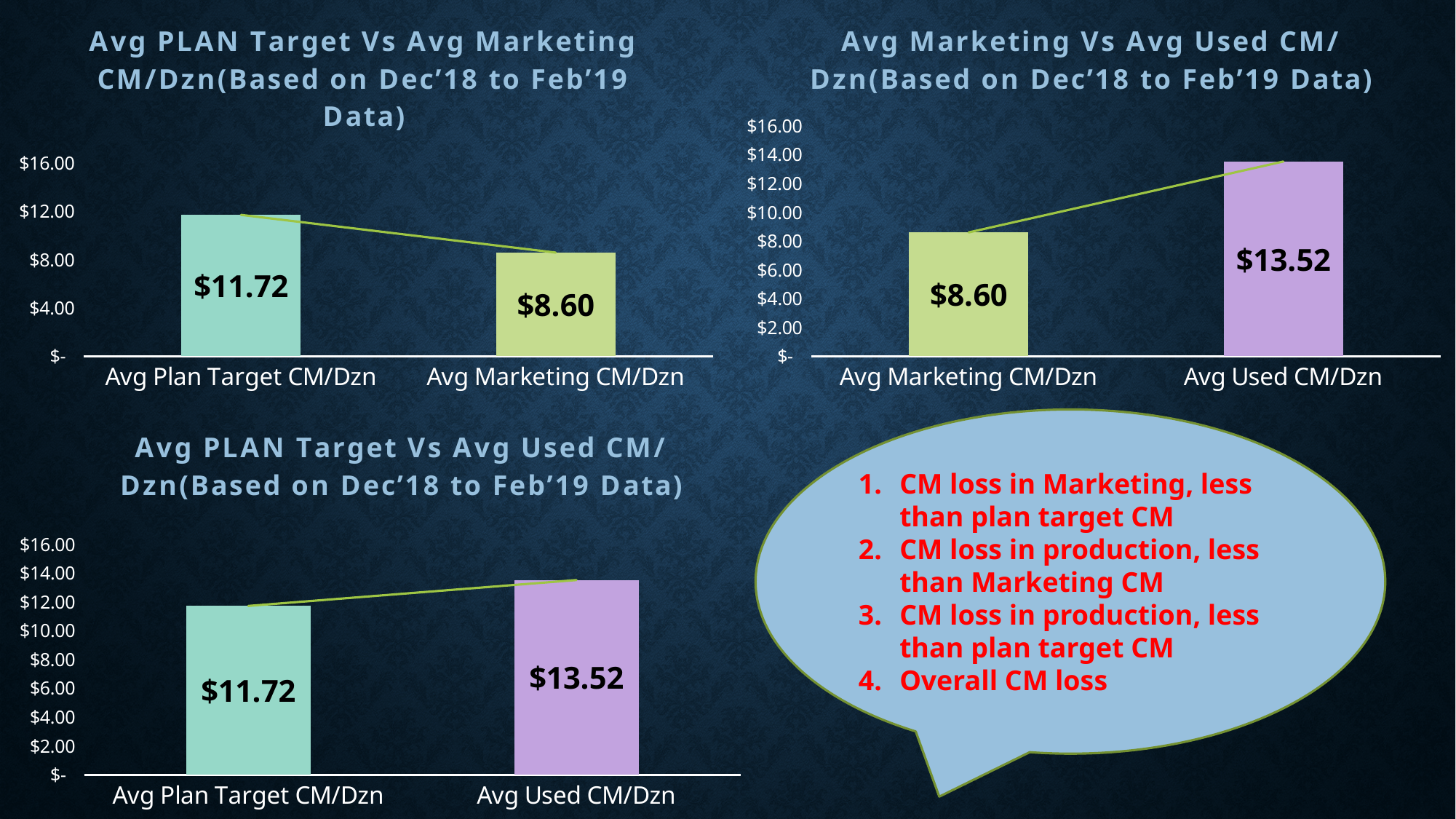
How many categories are shown in the bottom-left chart (Avg PLAN Target Vs Avg Used CM/Dzn)? 2 In the top-right chart (Avg Marketing Vs Avg Used CM/Dzn), which category has the lower value? Avg Marketing CM/Dzn In the bottom-left chart (Avg PLAN Target Vs Avg Used CM/Dzn), what is the difference between Avg Used CM/Dzn and Avg Plan Target CM/Dzn? $1.80 In the top-left chart (Avg PLAN Target Vs Avg Marketing CM/Dzn), what is the value for Avg Marketing CM/Dzn? $8.60 How many charts are shown on the slide? 3 In the top-left chart (Avg PLAN Target Vs Avg Marketing CM/Dzn), what is the difference between Avg Plan Target CM/Dzn and Avg Marketing CM/Dzn? $3.12 What kind of chart is the top-right chart (Avg Marketing Vs Avg Used CM/Dzn)? bar chart In the top-right chart (Avg Marketing Vs Avg Used CM/Dzn), what is the value for Avg Used CM/Dzn? $13.52 In the bottom-left chart (Avg PLAN Target Vs Avg Used CM/Dzn), is the value for Avg Used CM/Dzn larger or smaller than the value for Avg Plan Target CM/Dzn? larger In the top-left chart (Avg PLAN Target Vs Avg Marketing CM/Dzn), what is the value for Avg Plan Target CM/Dzn? $11.72 In the top-right chart (Avg Marketing Vs Avg Used CM/Dzn), is the value for Avg Marketing CM/Dzn greater or less than $10.00? less In the top-left chart (Avg PLAN Target Vs Avg Marketing CM/Dzn), which category has the higher value? Avg Plan Target CM/Dzn